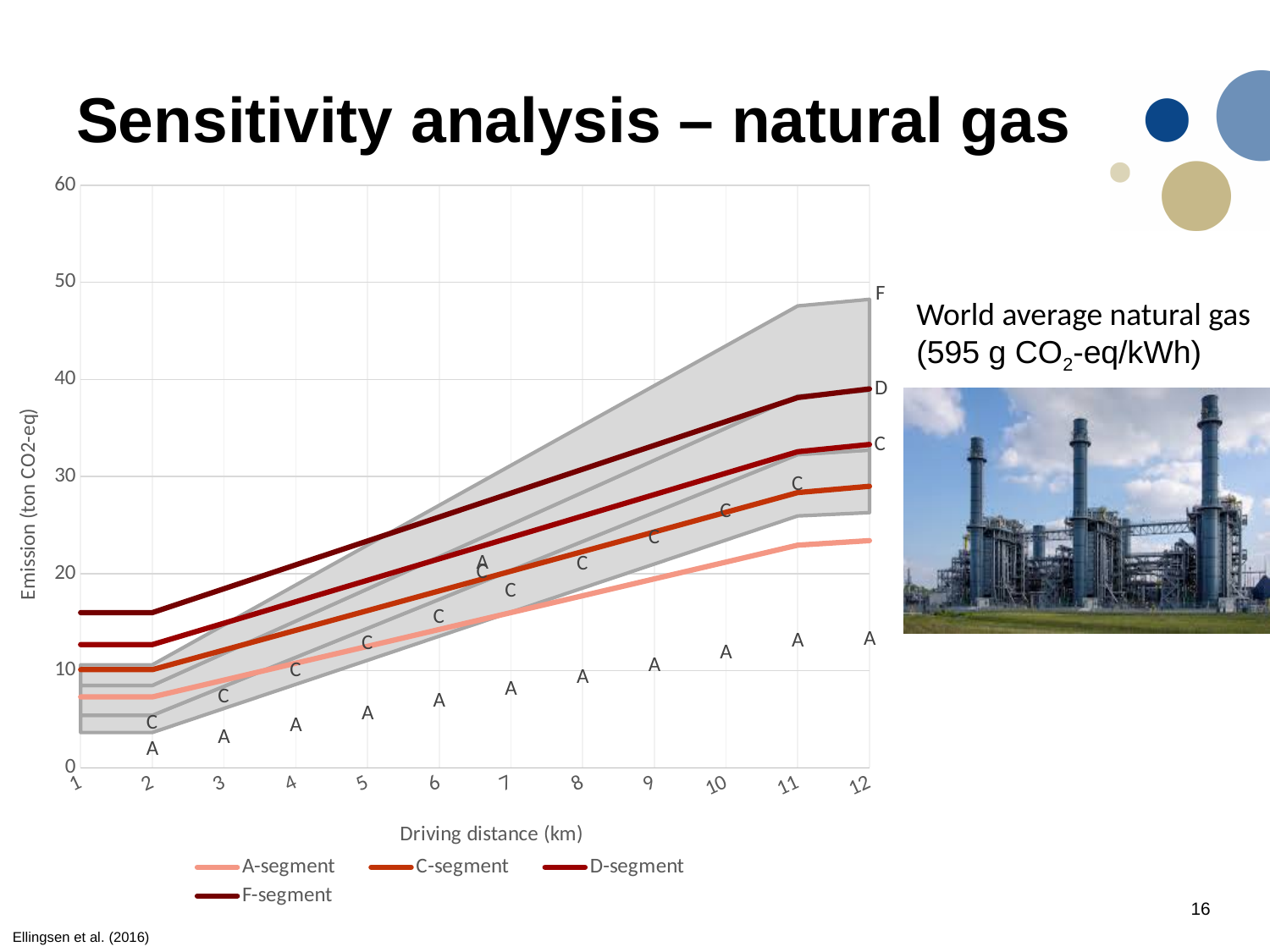
How many series does the chart legend list? 4 Do the emission values rise or fall as driving distance increases? rise What kind of chart is shown on the slide? combination area and line chart Which segment has the lowest emission at a driving distance of 12 km? A-segment What is the label of the y axis? Emission (ton CO2-eq) At 12 km, which is larger: the D-segment value or the C-segment value? D-segment Is the value for the A-segment at 12 km greater or less than 30? less Which segment has the highest emission at a driving distance of 12 km? F-segment Is the value for the F-segment at 12 km greater or less than 40? less Is the value for the A-segment at 1 km greater or less than 10? less How many driving distance values are shown along the x axis? 12